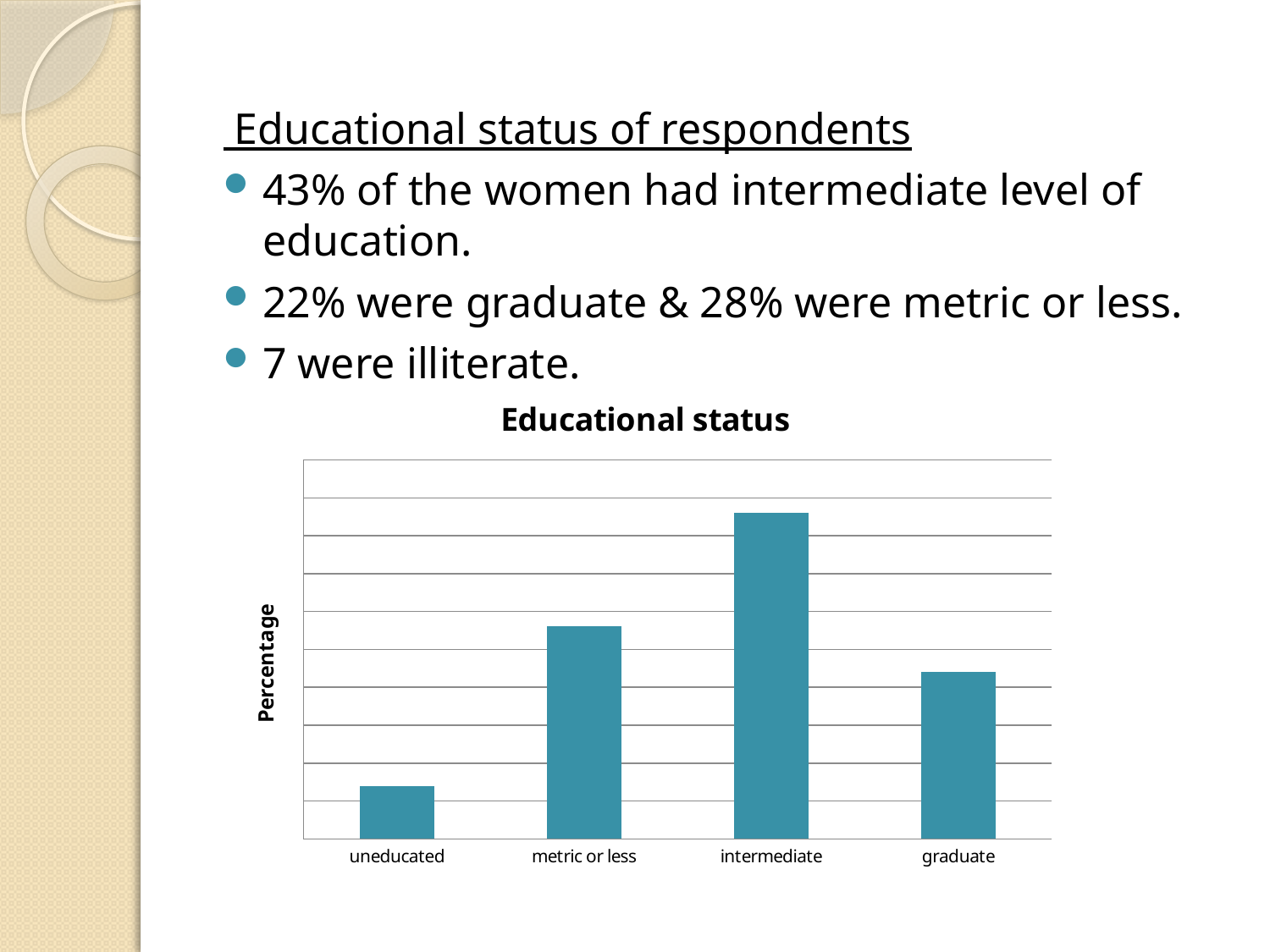
Which is larger in the chart, the bar for metric or less or the bar for graduate? metric or less Do the bar values rise or fall from intermediate to graduate along the x axis? fall Which category has the second-highest bar in the chart? metric or less What is the title of the chart? Educational status How many categories are shown on the x axis of the chart? 4 Which category has the highest bar in the chart? intermediate What kind of chart is shown on the slide? bar chart Which category has the lowest bar in the chart? uneducated What is the label on the vertical axis of the chart? Percentage Which is larger in the chart, the bar for intermediate or the bar for graduate? intermediate Which is larger in the chart, the bar for uneducated or the bar for metric or less? metric or less Do the bar values rise or fall from uneducated to intermediate along the x axis? rise